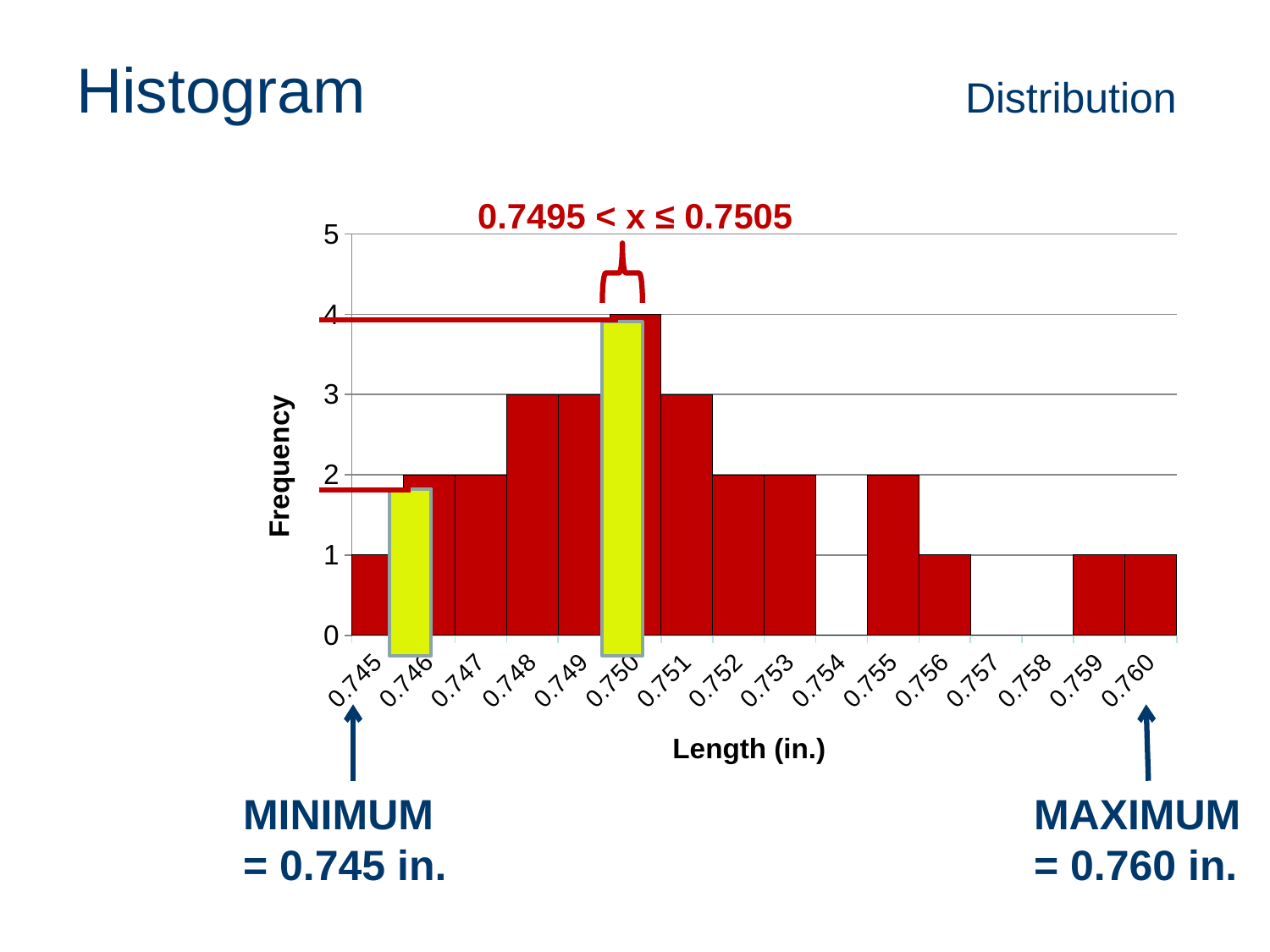
What is the title of the y axis? Frequency What kind of chart is shown on the slide? bar chart (histogram) Is the frequency for 0.749 in. greater or less than 2? greater How many length categories are labelled on the x axis? 16 What is the frequency for a length of 0.748 in.? 3 Which length has the highest frequency? 0.750 What is the title of the x axis? Length (in.) Which has a higher frequency, 0.751 in. or 0.752 in.? 0.751 What is the difference in frequency between 0.750 in. and 0.746 in.? 2 What is the frequency for a length of 0.755 in.? 2 What is the frequency for a length of 0.745 in.? 1 What is the frequency for a length of 0.750 in.? 4